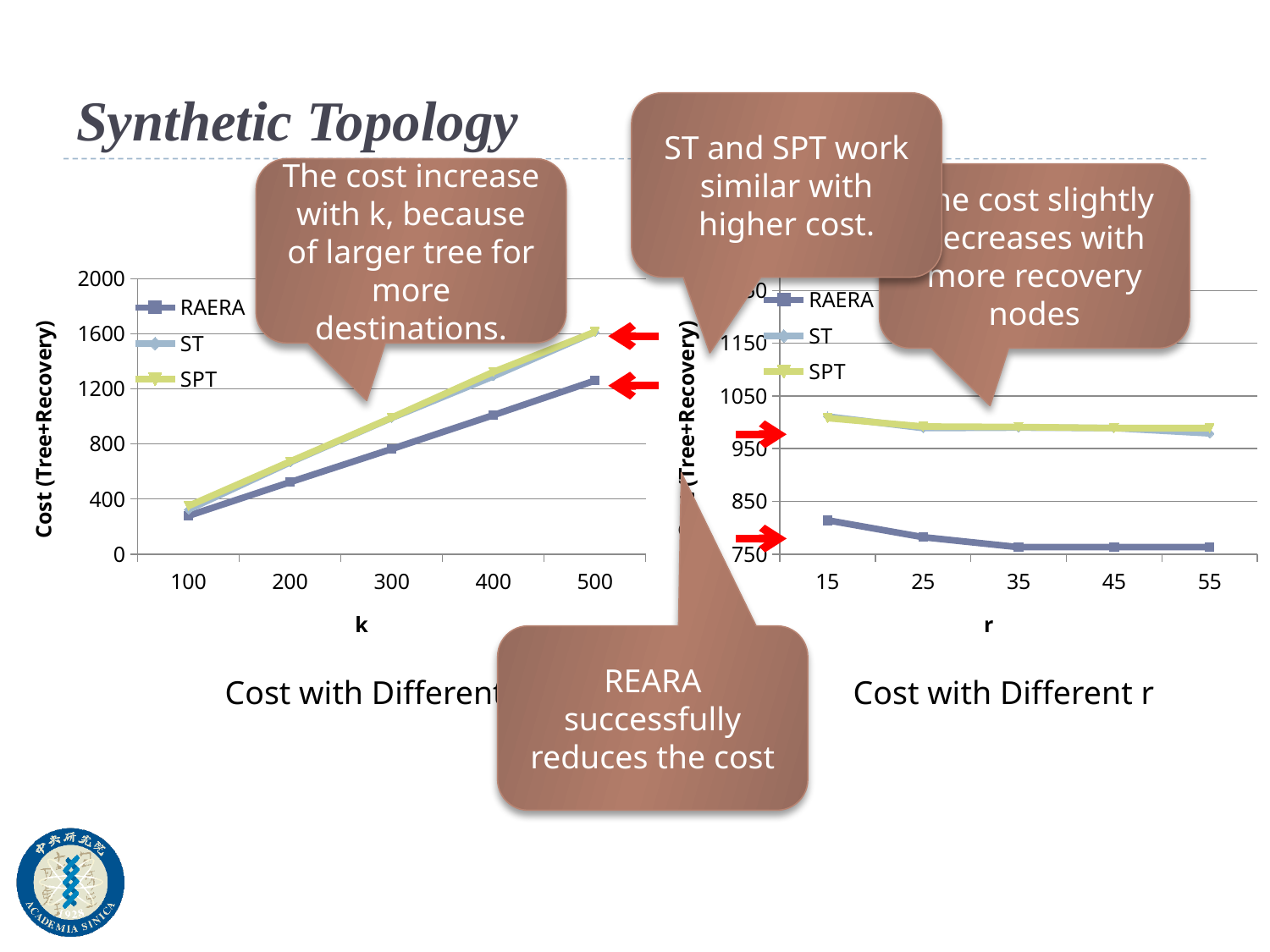
In the left chart (cost versus k), does the RAERA cost rise or fall as k increases? rise How many series does the legend of the left chart (cost versus k) list? 3 In the left chart (cost versus k), is the SPT value at k = 500 greater or less than 1200? greater In the left chart (cost versus k), is the RAERA value at k = 100 greater or less than 400? less In the left chart (cost versus k), which series has the lowest cost at k = 500? RAERA In the left chart (cost versus k), which is larger at k = 500, SPT or RAERA? SPT In the 'Cost with Different r' chart, is the RAERA value at r = 15 greater or less than 850? less How many k values are plotted on the x axis of the left chart? 5 In the 'Cost with Different r' chart, which is larger at r = 55, ST or RAERA? ST In the 'Cost with Different r' chart, does the RAERA cost rise or fall as r increases? fall What kind of chart is the left chart (cost versus k)? line chart